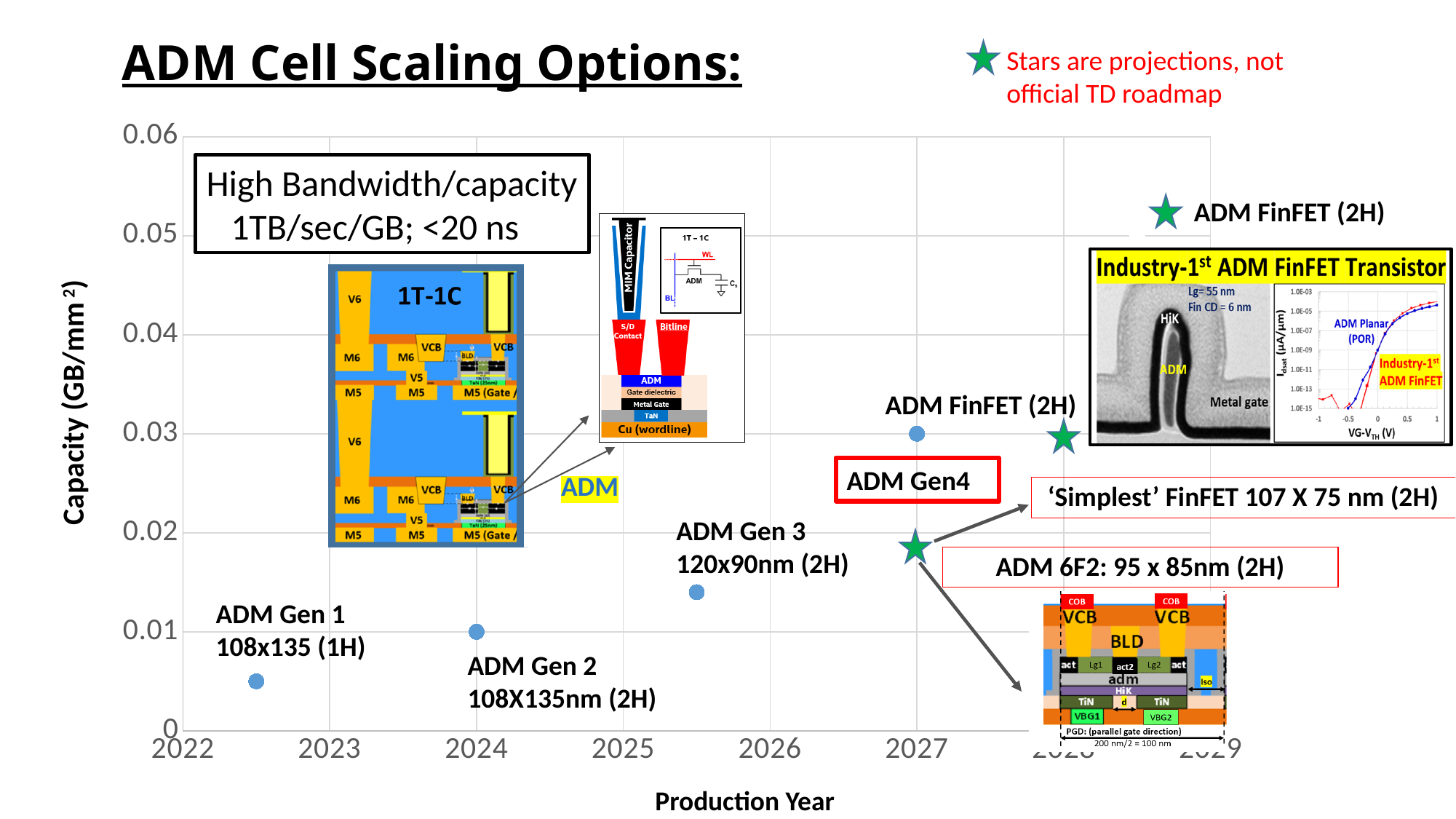
Which plotted point has the lowest capacity? ADM Gen 1 Is the capacity value for ADM Gen 1 greater or less than 0.01? less What kind of chart is shown on the slide? scatter chart What is the capacity value plotted for ADM Gen 2? 0.01 Is the capacity value for ADM Gen 3 greater or less than 0.02? less According to the legend note, what do the stars on the chart represent? projections, not official TD roadmap Which has the higher plotted capacity, ADM Gen 3 or ADM Gen 2? ADM Gen 3 In which production year is ADM Gen 2 plotted? 2024 Do the plotted capacity values generally rise or fall as the production year increases? rise What is the title of the x axis of the chart? Production Year